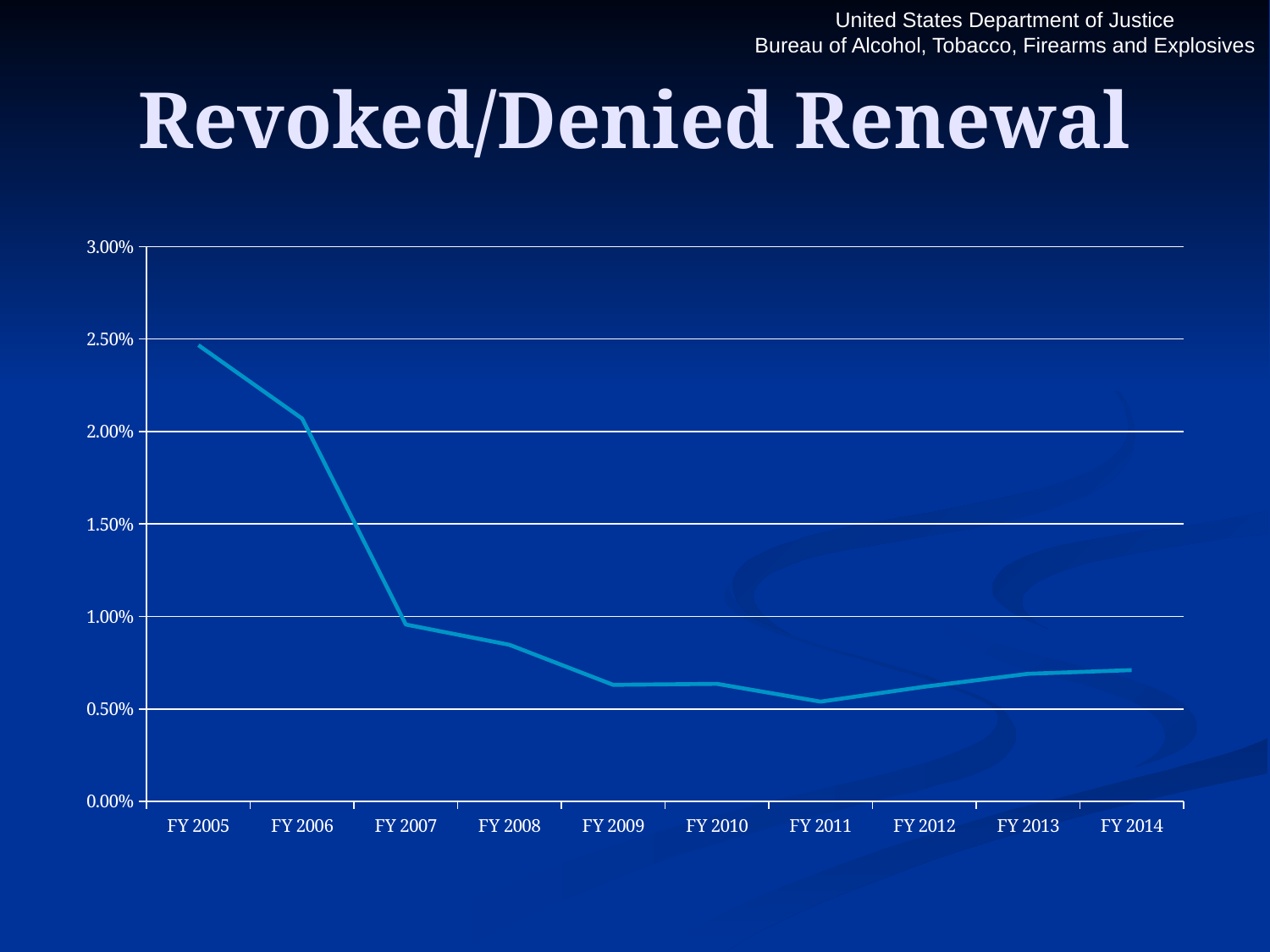
How many fiscal years are plotted on the x axis? 10 Is the value for FY 2006 greater or less than 1.50%? greater What is the highest value shown on the y axis? 3.00% Is the value for FY 2005 greater or less than 2.00%? greater Is the value for FY 2014 greater or less than 1.00%? less What is the title of the chart? Revoked/Denied Renewal Which is larger, the value for FY 2006 or the value for FY 2007? FY 2006 Which fiscal year has the lowest value? FY 2011 Do the values rise or fall from FY 2005 to FY 2011? fall Which fiscal year has the highest value? FY 2005 What kind of chart is shown on the slide? line chart